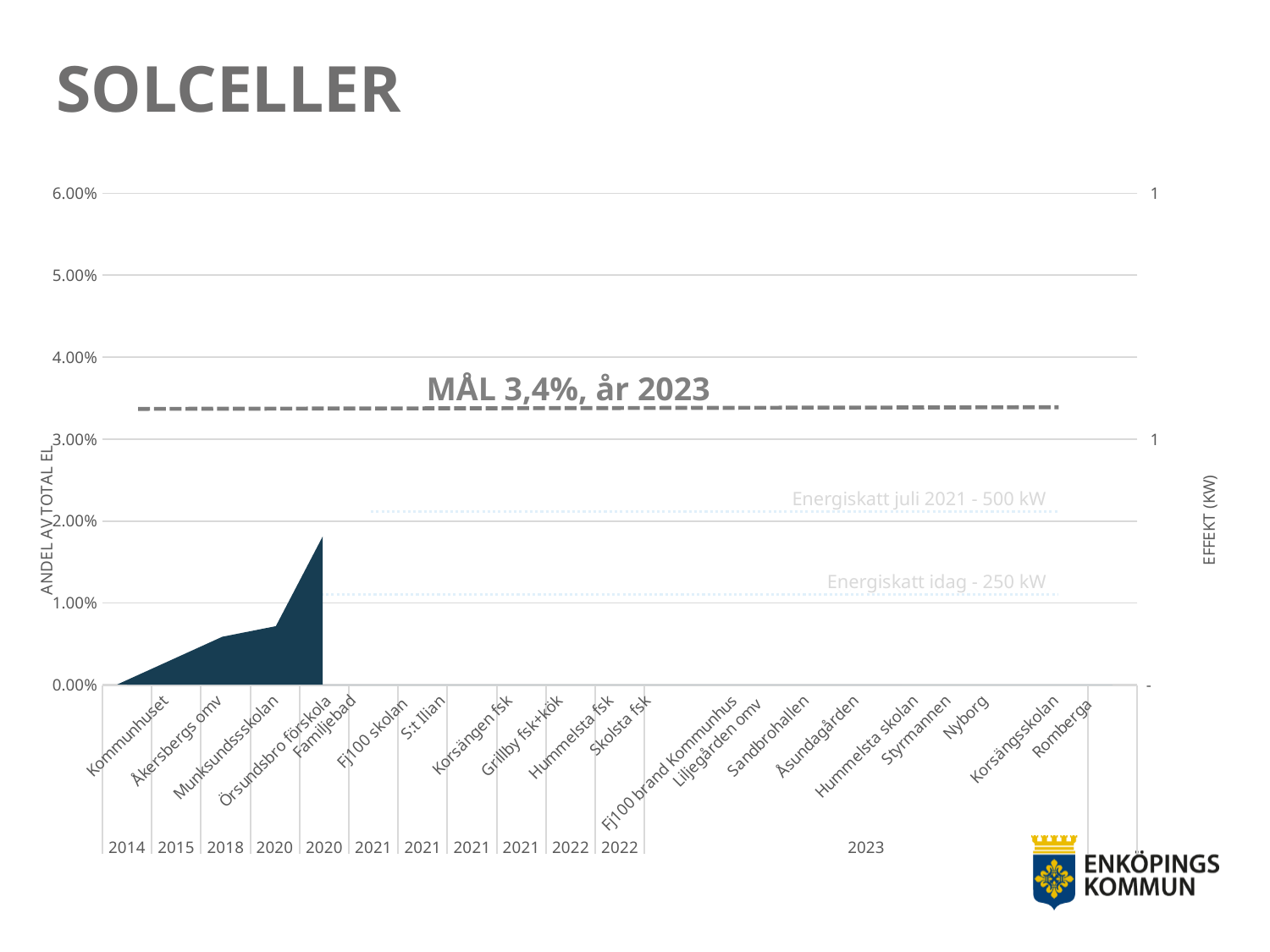
What is the title of the slide? SOLCELLER What target is stated by the dashed line label on the chart? MÅL 3,4%, år 2023 Which is larger, the value for Örsundsbro förskola or the value for Munksundsskolan? Örsundsbro förskola Is the value for Örsundsbro förskola greater or less than 2.00%? less What year is shown beneath Kommunhuset on the x axis? 2014 Which category has the highest plotted share of total electricity? Familjebad What kind of chart is shown on the slide? area chart Does the plotted share rise or fall from Kommunhuset to Örsundsbro förskola? rise Is the value for Örsundsbro förskola greater or less than 1.00%? less Which category has the lowest plotted share of total electricity? Kommunhuset Is the value for Munksundsskolan greater or less than 1.00%? less